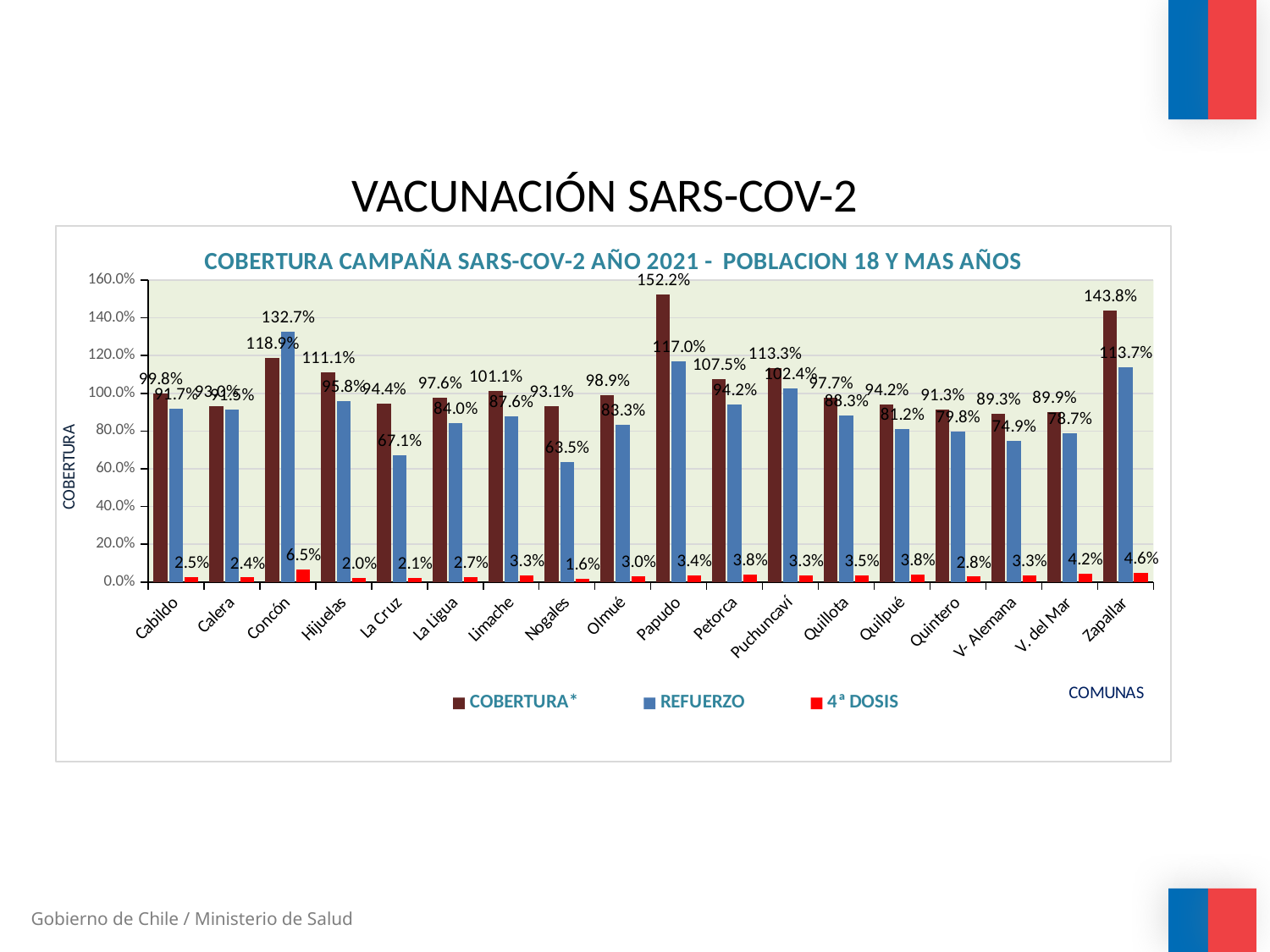
What is the difference between the COBERTURA* and REFUERZO values for Papudo? 35.2 percentage points How many series does the legend list? 3 What type of chart is shown on the slide? Bar chart Which comuna has the highest 4ª DOSIS value? Concón What is the COBERTURA* value for Papudo? 152.2% Which comuna has the highest COBERTURA* value? Papudo Which is larger, the COBERTURA* value for Zapallar or for Papudo? Papudo What is the 4ª DOSIS value for Zapallar? 4.6% How many comunas (categories) are shown on the x axis? 18 What is the title of the chart? COBERTURA CAMPAÑA SARS-COV-2 AÑO 2021 - POBLACION 18 Y MAS AÑOS Which comuna has the lowest REFUERZO value? Nogales What is the REFUERZO value for Concón? 132.7%